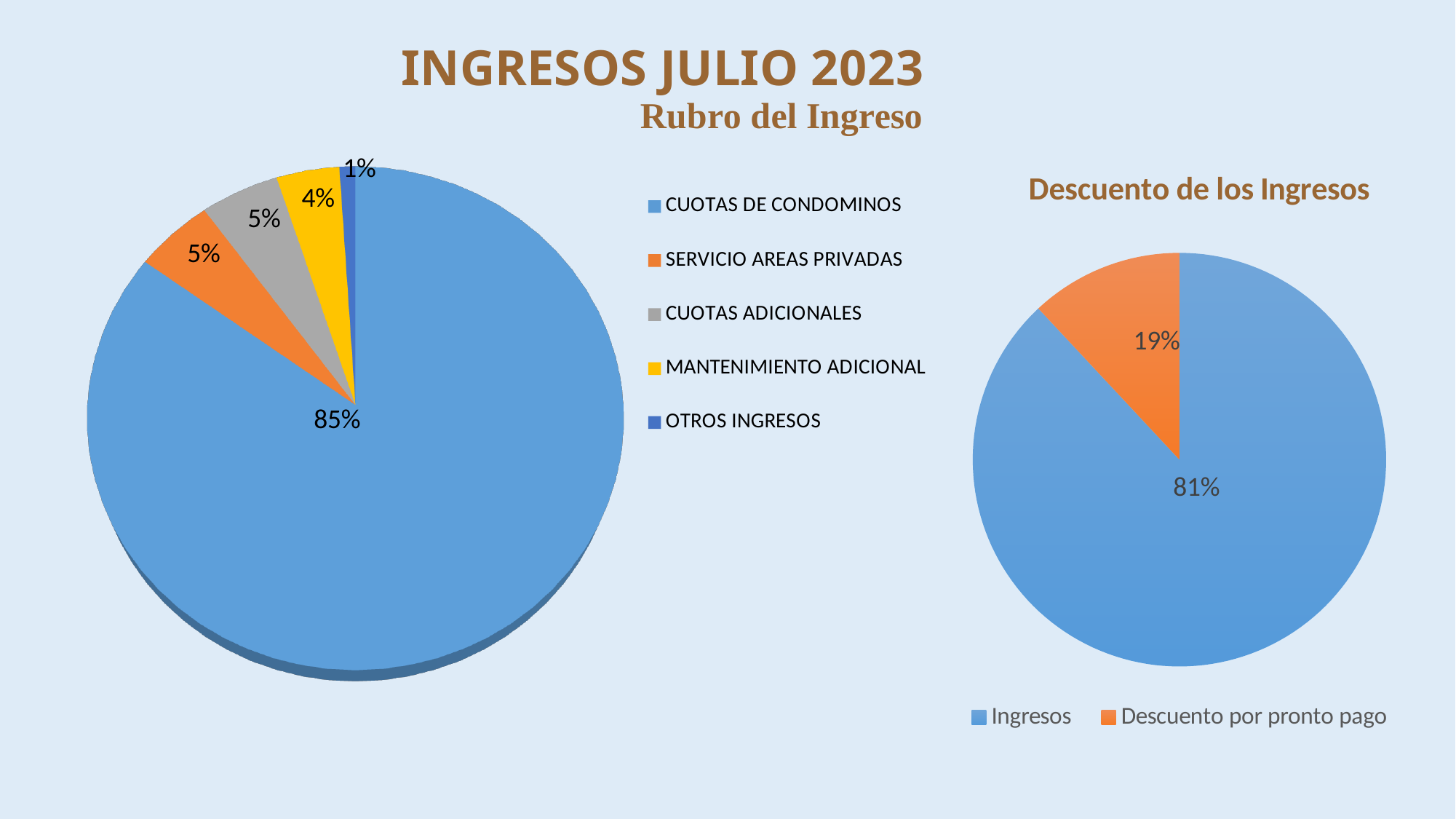
In the 'Rubro del Ingreso' chart, which category has the largest slice? CUOTAS DE CONDOMINOS In the 'Rubro del Ingreso' chart, what share does CUOTAS DE CONDOMINOS have? 85% In the 'Rubro del Ingreso' chart, what share does MANTENIMIENTO ADICIONAL have? 4% In the 'Rubro del Ingreso' chart, what is the difference between the shares of CUOTAS DE CONDOMINOS and MANTENIMIENTO ADICIONAL? 81% In the 'Descuento de los Ingresos' chart, what share does Ingresos have? 81% What type of chart is 'Descuento de los Ingresos'? Pie chart In the 'Rubro del Ingreso' chart, how many categories does the legend list? 5 In the 'Rubro del Ingreso' chart, what colour is the SERVICIO AREAS PRIVADAS slice? Orange In the 'Descuento de los Ingresos' chart, which is larger, Ingresos or Descuento por pronto pago? Ingresos In the 'Rubro del Ingreso' chart, which category has the smallest slice? OTROS INGRESOS